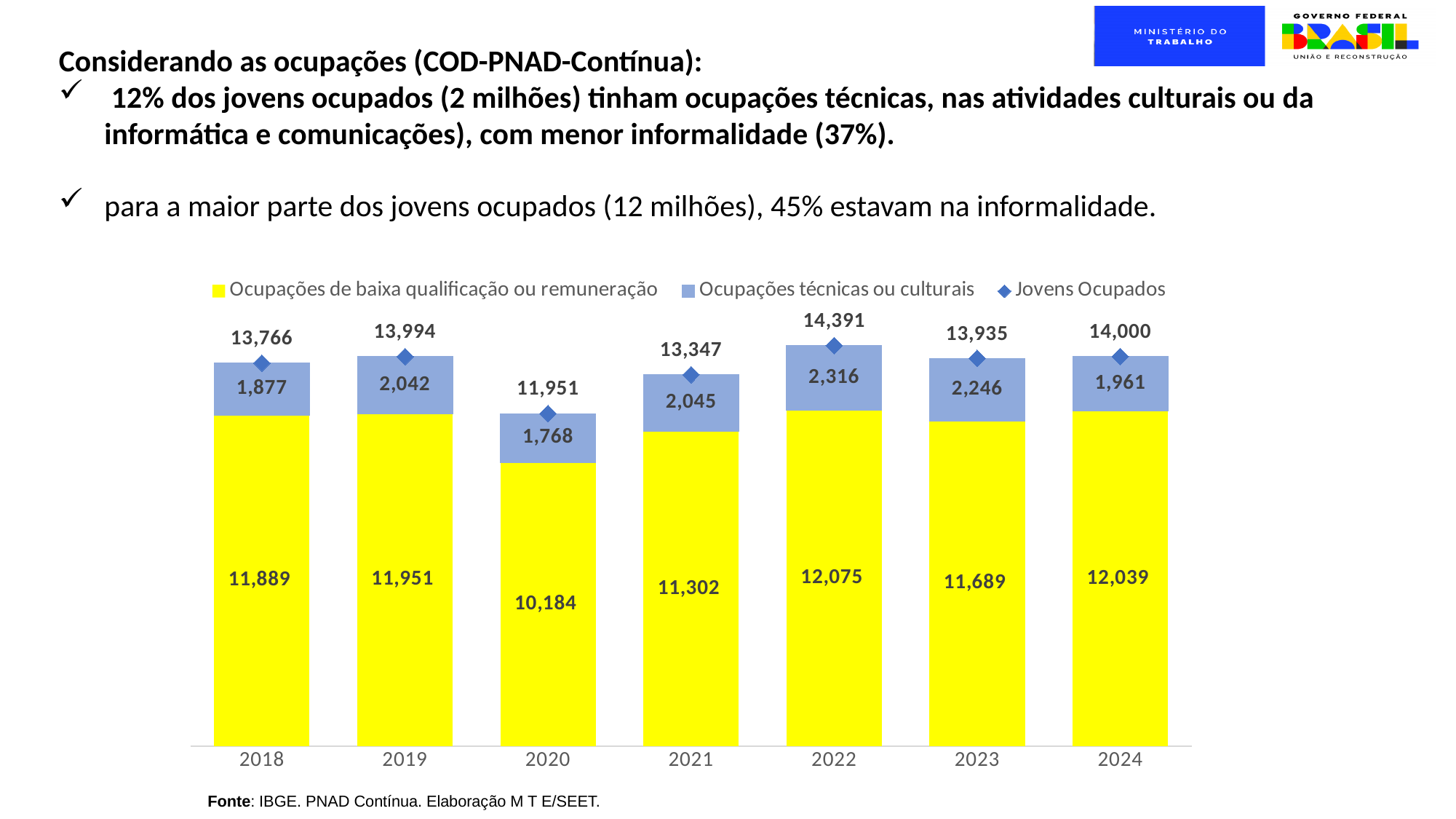
In which year is the value for Jovens Ocupados highest? 2022 Does the value for Ocupações de baixa qualificação ou remuneração rise or fall from 2020 to 2022? rise In which year is the value for Ocupações de baixa qualificação ou remuneração lowest? 2020 What is the value for Ocupações de baixa qualificação ou remuneração in 2020? 10,184 Which year has the larger value for Ocupações técnicas ou culturais, 2023 or 2024? 2023 What is the value for Ocupações técnicas ou culturais in 2022? 2,316 What is the difference between the Ocupações técnicas ou culturais values for 2022 and 2018? 439 What kind of chart is shown on the slide? combination stacked bar and line chart How many years are shown on the x axis of the chart? 7 What is the difference between the Jovens Ocupados values for 2022 and 2020? 2,440 How many series does the legend list? 3 What is the value for Jovens Ocupados in 2024? 14,000